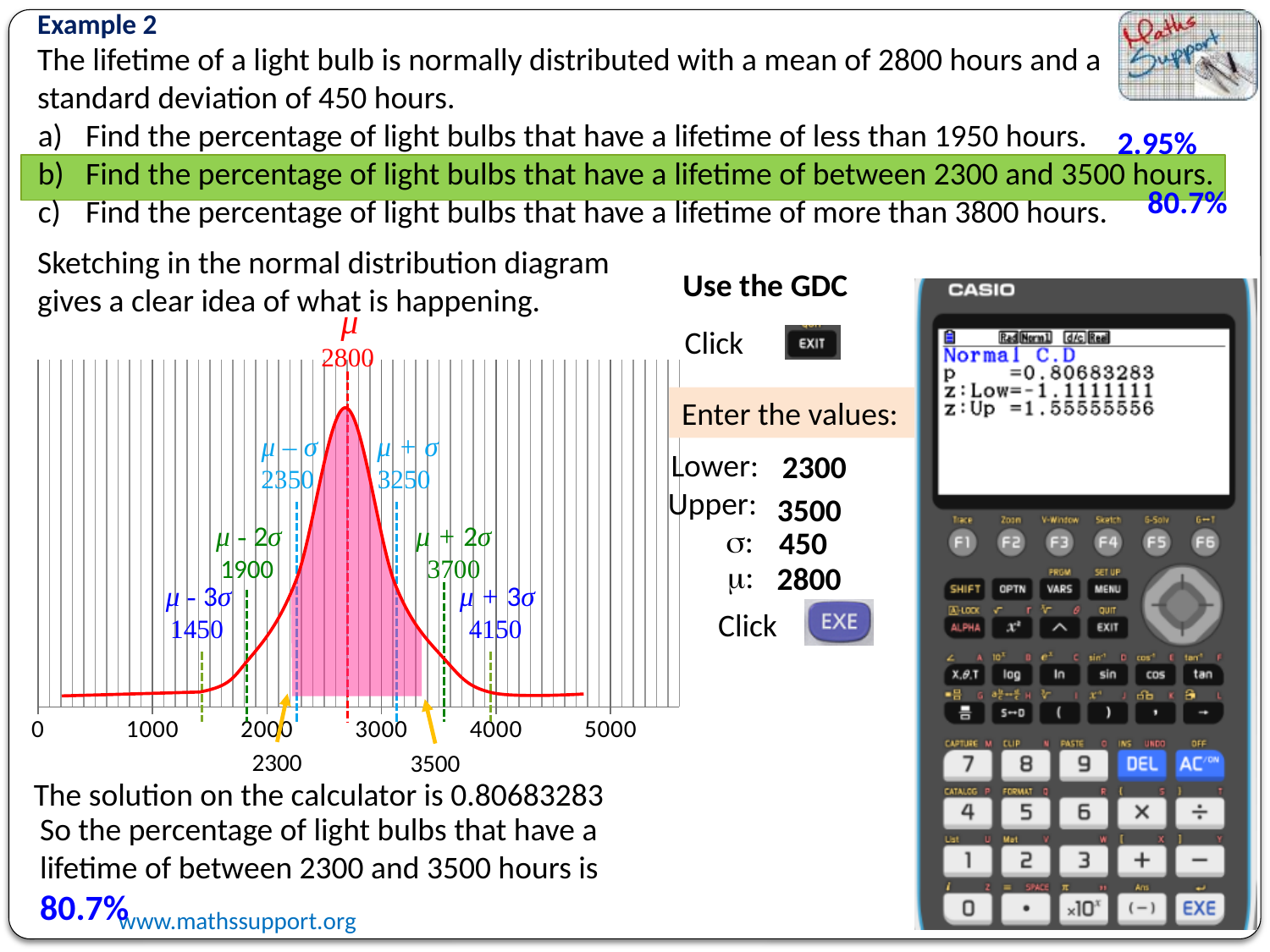
What value is labelled at the mean μ on the normal distribution diagram? 2800 What kind of chart is the normal distribution diagram on the slide? line chart Which is larger on the diagram, the value at μ + 2σ or the value at μ + 3σ? μ + 3σ (4150) Does the curve rise or fall along the x axis between 2800 and 4000? fall What colour is the shaded region under the curve between 2300 and 3500? pink What value is labelled at μ + 2σ on the normal distribution diagram? 3700 What value is labelled at μ + σ on the normal distribution diagram? 3250 What is the lower boundary value of the shaded region on the normal distribution diagram? 2300 What is the difference between the values labelled at μ + σ and μ - σ on the diagram? 900 What is the width of the shaded region on the diagram, from 2300 to 3500? 1200 What value is labelled at μ - 3σ on the normal distribution diagram? 1450 How many labelled tick values are shown on the x axis of the normal distribution diagram? 6